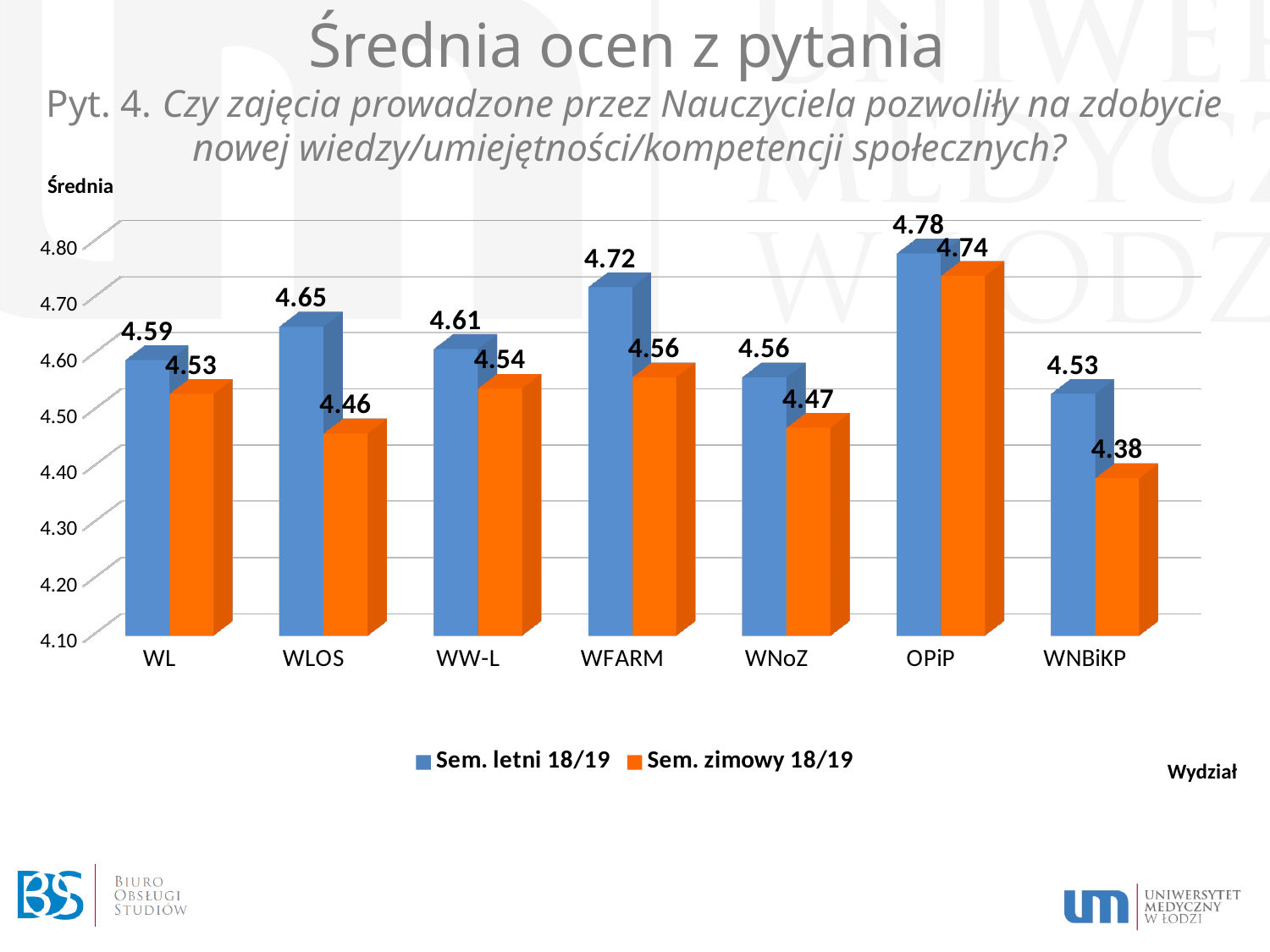
What is the value for WNBiKP in the Sem. zimowy 18/19 series? 4.38 What label is shown on the vertical axis of the chart? Średnia What is the difference between the Sem. letni 18/19 and Sem. zimowy 18/19 values for WLOS? 0.19 How many categories (faculties) are shown on the x axis? 7 How many series does the legend list? 2 What kind of chart is shown on the slide? bar chart What is the value for WLOS in the Sem. zimowy 18/19 series? 4.46 Which category has the lowest value in the Sem. zimowy 18/19 series? WNBiKP What is the difference between the Sem. letni 18/19 values for OPiP and WNBiKP? 0.25 Which category has the highest value in the Sem. letni 18/19 series? OPiP What is the value for WFARM in the Sem. letni 18/19 series? 4.72 Which is larger for WNoZ: the Sem. letni 18/19 value or the Sem. zimowy 18/19 value? Sem. letni 18/19